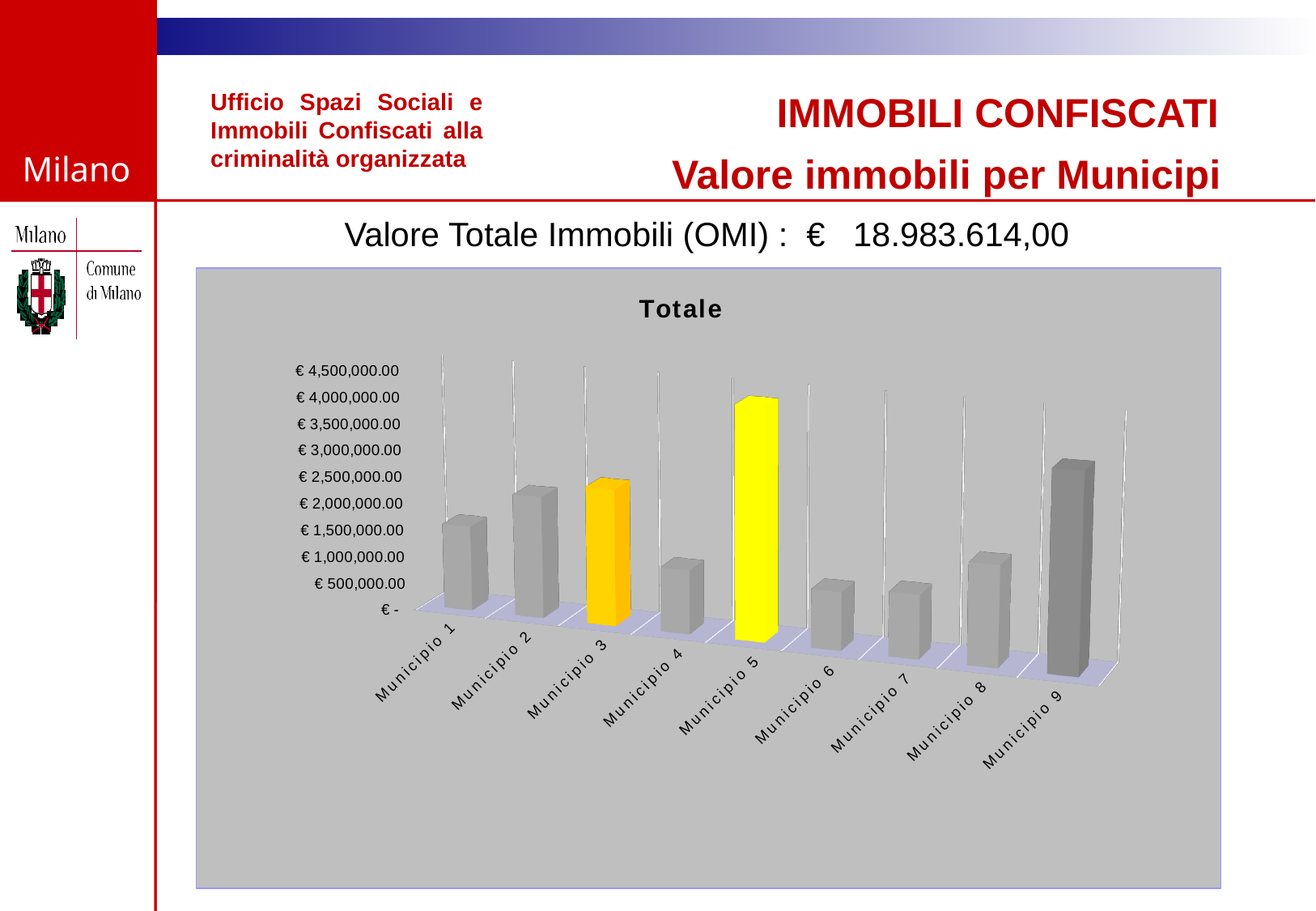
What kind of chart is shown on the slide? bar chart Which municipio has the highest value in the chart? Municipio 5 What is the title of the chart? Totale What colour is the bar for Municipio 5? yellow How many municipi (categories) are plotted in the chart? 9 Which has a larger value, Municipio 5 or Municipio 1? Municipio 5 Which has a larger value, Municipio 9 or Municipio 4? Municipio 9 Is the value for Municipio 1 greater or less than € 2,500,000.00? less Is the value for Municipio 9 greater or less than € 2,000,000.00? greater Is the value for Municipio 5 greater or less than € 3,500,000.00? greater